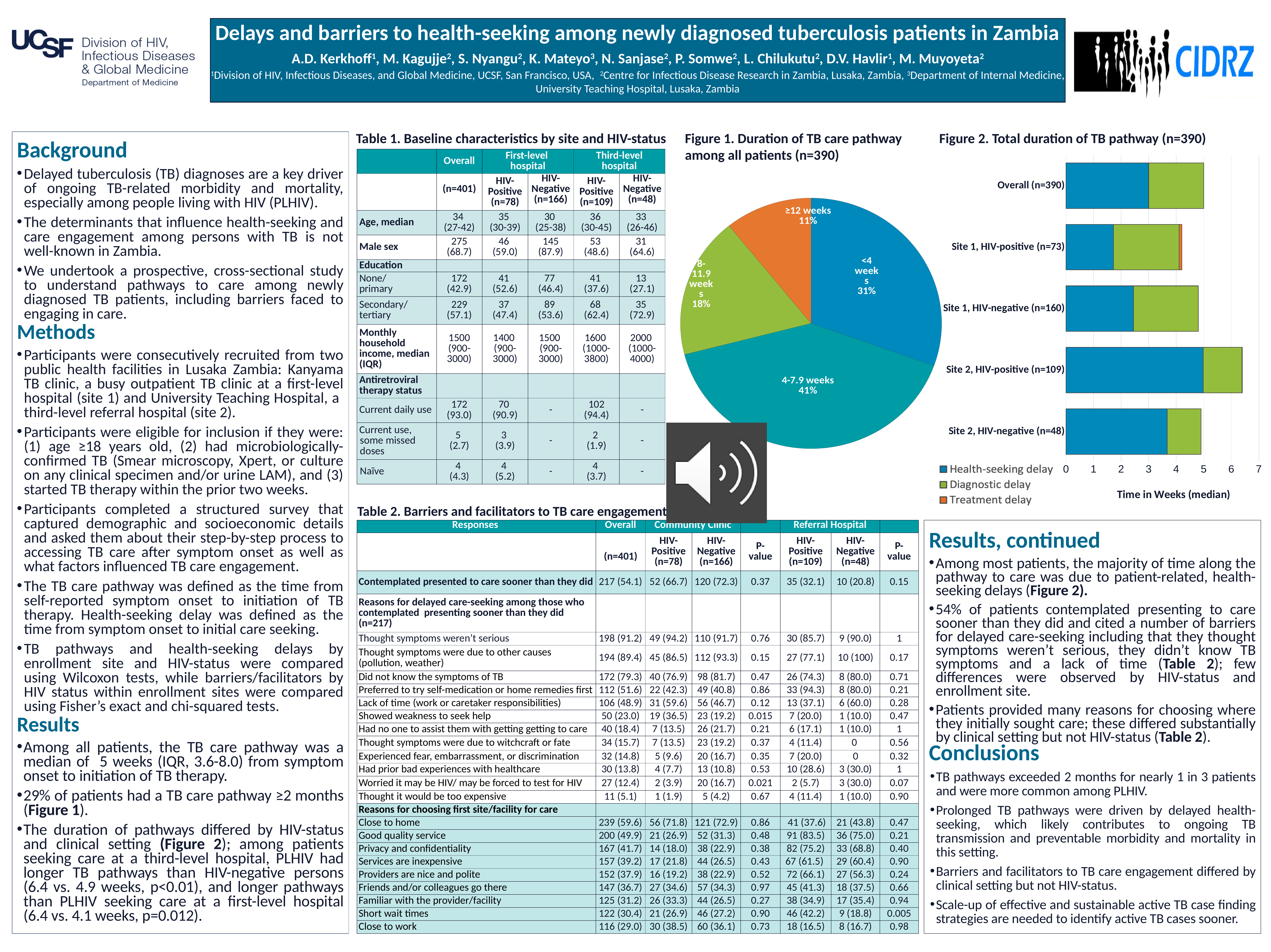
In Figure 1, what percentage of patients had a TB care pathway of 4-7.9 weeks? 41% In Figure 1, how many slices does the pie chart have? 4 In Figure 2, how many series does the legend list? 3 In Figure 2, which group has the longest total TB pathway bar? Site 2, HIV-positive (n=109) In Figure 1, what percentage of patients had a TB care pathway of ≥12 weeks? 11% In Figure 1, which duration category has the smallest share of patients? ≥12 weeks In Figure 2, what is the label of the x axis? Time in Weeks (median) In Figure 1, which duration category has the largest share of patients? 4-7.9 weeks What type of chart is Figure 2? Stacked bar chart In Figure 2, is the total bar length for Site 2, HIV-positive (n=109) greater or less than 6 weeks? greater What type of chart is Figure 1? Pie chart In Figure 1, how many percentage points larger is the <4 weeks slice than the 8-11.9 weeks slice? 13